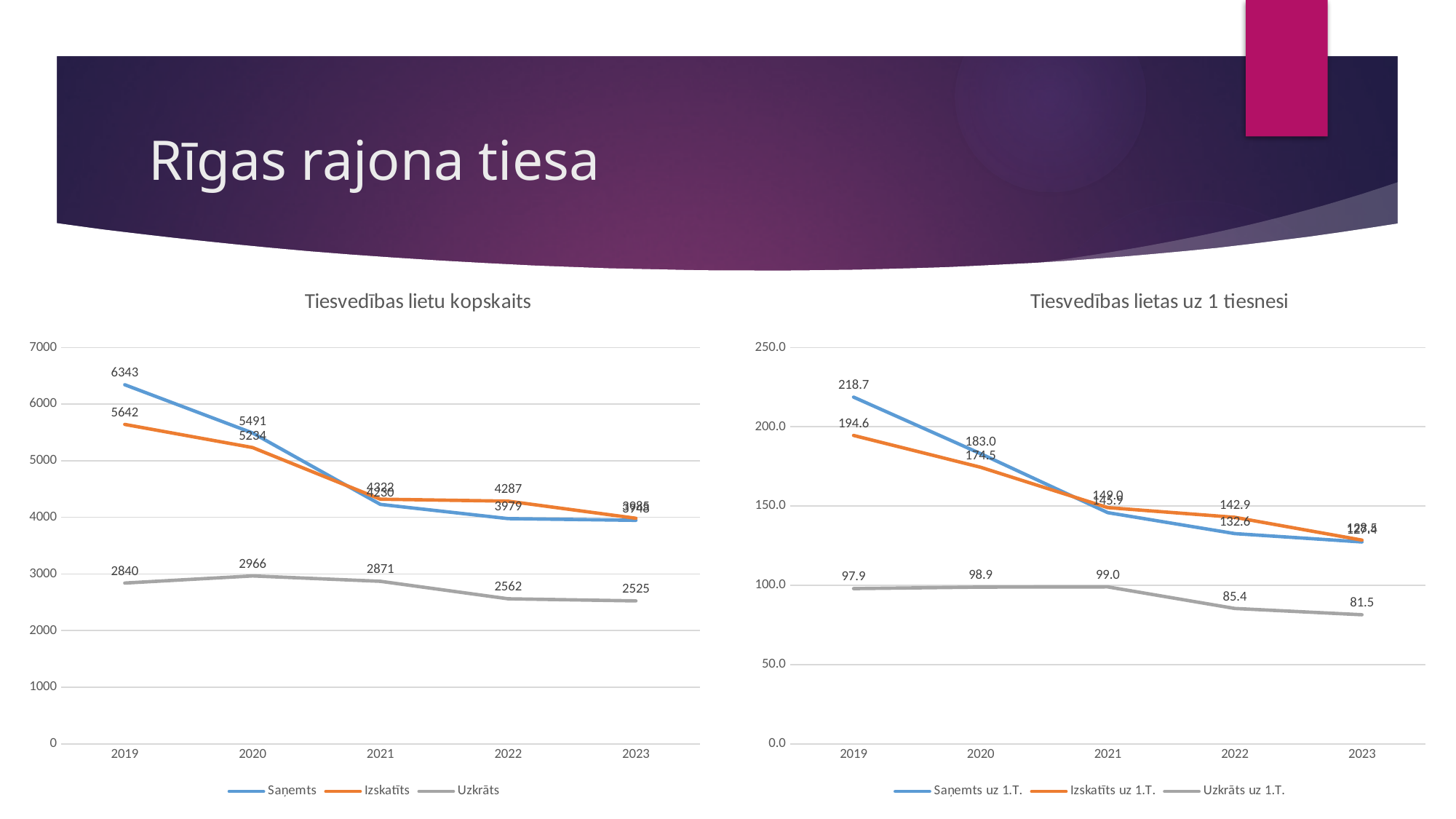
What kind of chart is "Tiesvedības lietas uz 1 tiesnesi"? line chart In the chart titled "Tiesvedības lietas uz 1 tiesnesi", in which year is Uzkrāts uz 1.T. lowest? 2023 In the chart titled "Tiesvedības lietas uz 1 tiesnesi", what is the value of Saņemts uz 1.T. in 2019? 218.7 In the chart titled "Tiesvedības lietas uz 1 tiesnesi", how many years are shown on the x axis? 5 In the chart titled "Tiesvedības lietu kopskaits", which is larger in 2022: Saņemts or Izskatīts? Izskatīts In the chart titled "Tiesvedības lietas uz 1 tiesnesi", what is the value of Uzkrāts uz 1.T. in 2023? 81.5 In the chart titled "Tiesvedības lietu kopskaits", in which year is Uzkrāts highest? 2020 In the chart titled "Tiesvedības lietu kopskaits", what is the value of Saņemts in 2019? 6343 In the chart titled "Tiesvedības lietu kopskaits", does Saņemts rise or fall from 2019 to 2022? fall In the chart titled "Tiesvedības lietu kopskaits", what is the value of Uzkrāts in 2022? 2562 In the chart titled "Tiesvedības lietu kopskaits", what is the difference between Saņemts and Izskatīts in 2019? 701 In the chart titled "Tiesvedības lietu kopskaits", how many series does the legend list? 3